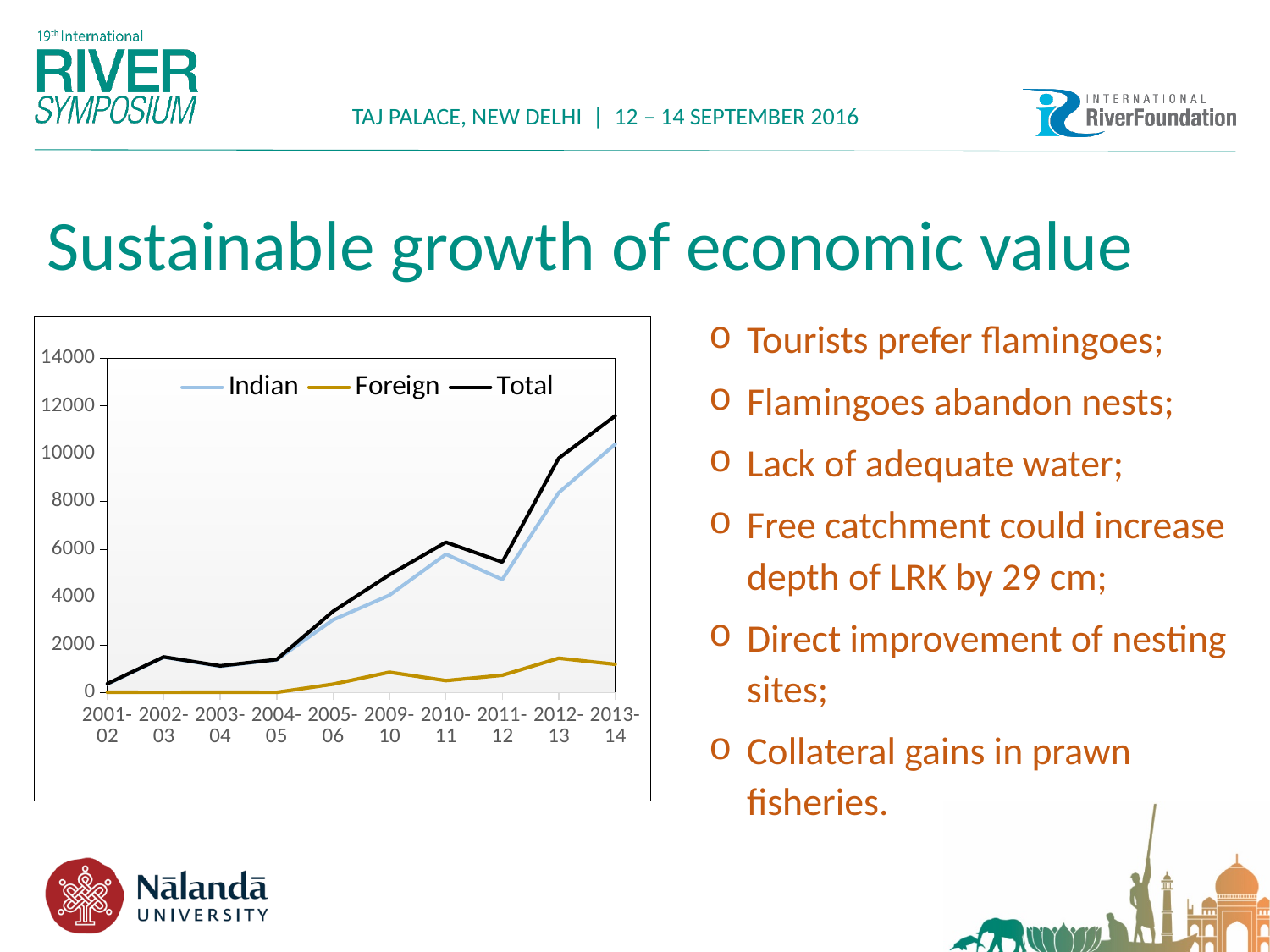
Is the Foreign value for 2012-13 greater or less than 2000? less In which period does the Foreign series reach its highest value? 2012-13 Which series has the larger value in 2013-14, Indian or Foreign? Indian In which period is the Total series at its lowest value? 2001-02 In which period does the Total series reach its highest value? 2013-14 Is the Total value for 2001-02 greater or less than 2000? less How many periods are shown along the x axis of the chart? 10 How many series does the chart legend list? 3 Which series are listed in the chart legend? Indian, Foreign, Total What kind of chart is shown on the slide? line chart Does the Total series generally rise or fall from 2001-02 to 2013-14? rise Is the Total value for 2013-14 greater or less than 10000? greater